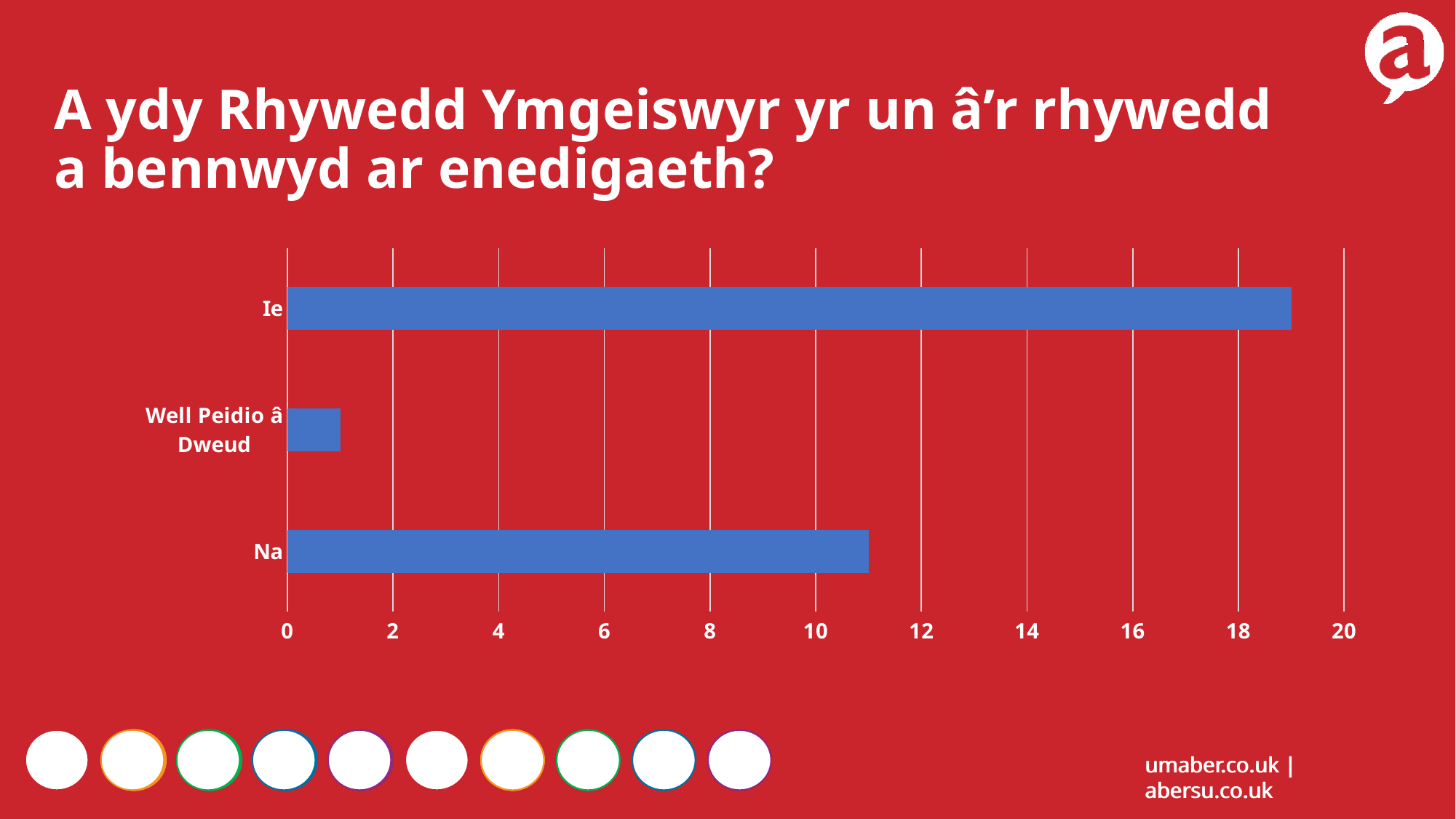
Is the value for Na greater or less than 10? greater Is the value for Ie greater or less than 18? greater What colour are the bars in the chart? blue Is the value for Well Peidio â Dweud greater or less than 2? less What is the highest value shown on the horizontal axis? 20 Which is larger, the value for Ie or the value for Na? Ie What kind of chart is shown on the slide? bar chart Which category has the highest value? Ie Which category has the lowest value? Well Peidio â Dweud How many categories are plotted in the chart? 3 Which is larger, the value for Na or the value for Well Peidio â Dweud? Na